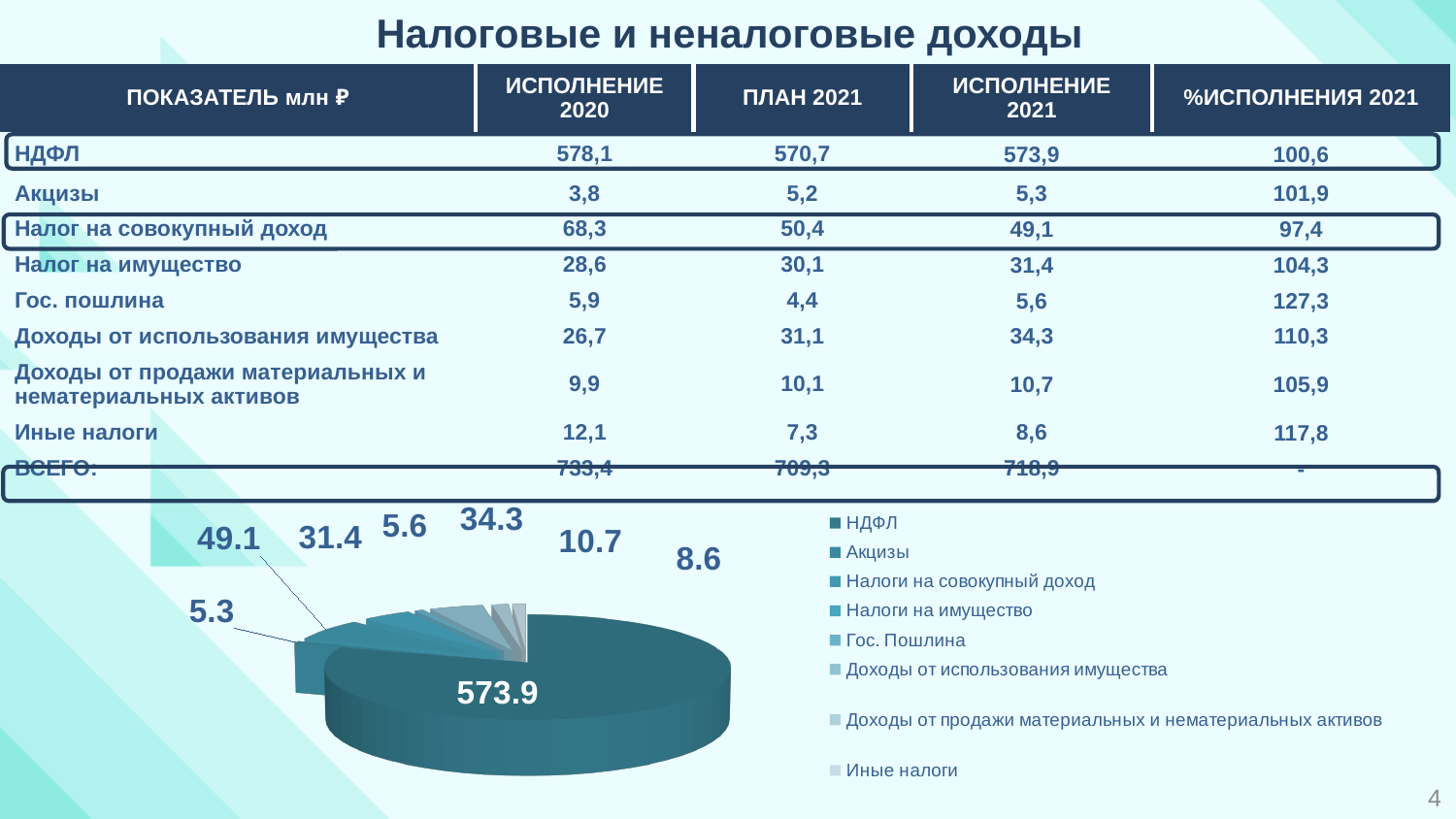
What is the sum of all the values shown in the pie chart? 718.9 In the pie chart, what value is shown for Налоги на совокупный доход? 49.1 How many slices does the pie chart have? 8 In the pie chart, which is larger: Доходы от использования имущества or Налоги на имущество? Доходы от использования имущества Which category has the largest slice in the pie chart? НДФЛ Which category has the smallest value in the pie chart? Акцизы In the pie chart, what value is shown for Иные налоги? 8.6 In the pie chart, what is the difference between the value for НДФЛ and the value for Налоги на совокупный доход? 524.8 In the pie chart, what value is shown for НДФЛ? 573.9 In the pie chart, what value is shown for Доходы от использования имущества? 34.3 What kind of chart is shown at the bottom of the slide? Pie chart How many entries does the pie chart's legend list? 8